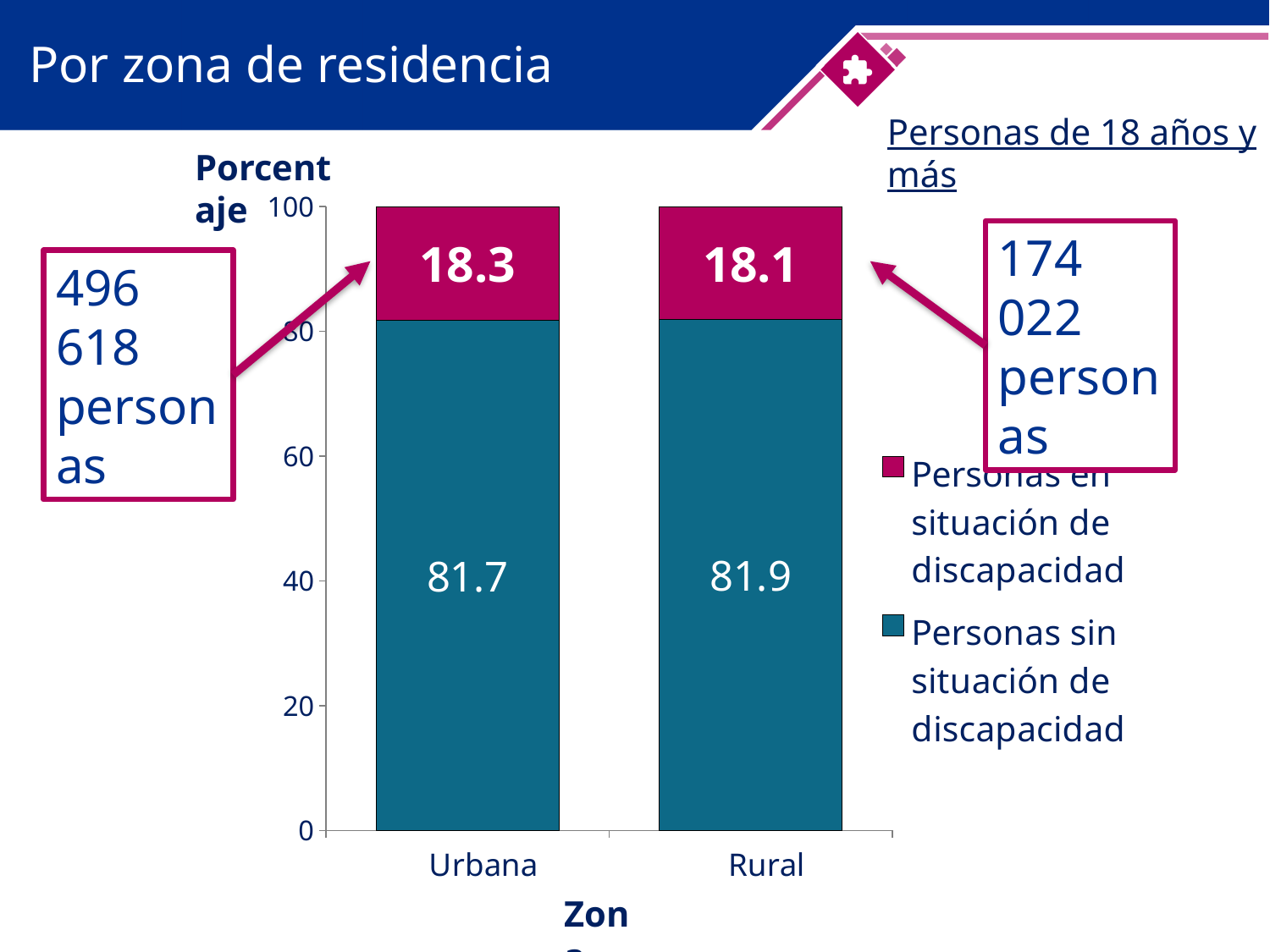
What is the value for 'Personas sin situación de discapacidad' in the Rural category? 81.9 What kind of chart is shown on the slide? Stacked bar chart How many series does the legend list? 2 What is the total of the stacked bar for Urbana? 100 How many categories are shown on the x axis? 2 What is the total of the stacked bar for Rural? 100 What is the value for 'Personas en situación de discapacidad' in the Rural category? 18.1 What is the difference between the 'Personas en situación de discapacidad' values for Urbana and Rural? 0.2 What is the difference between the 'Personas sin situación de discapacidad' values for Rural and Urbana? 0.2 What is the label of the y axis? Porcentaje What is the value for 'Personas sin situación de discapacidad' in the Urbana category? 81.7 What is the value for 'Personas en situación de discapacidad' in the Urbana category? 18.3